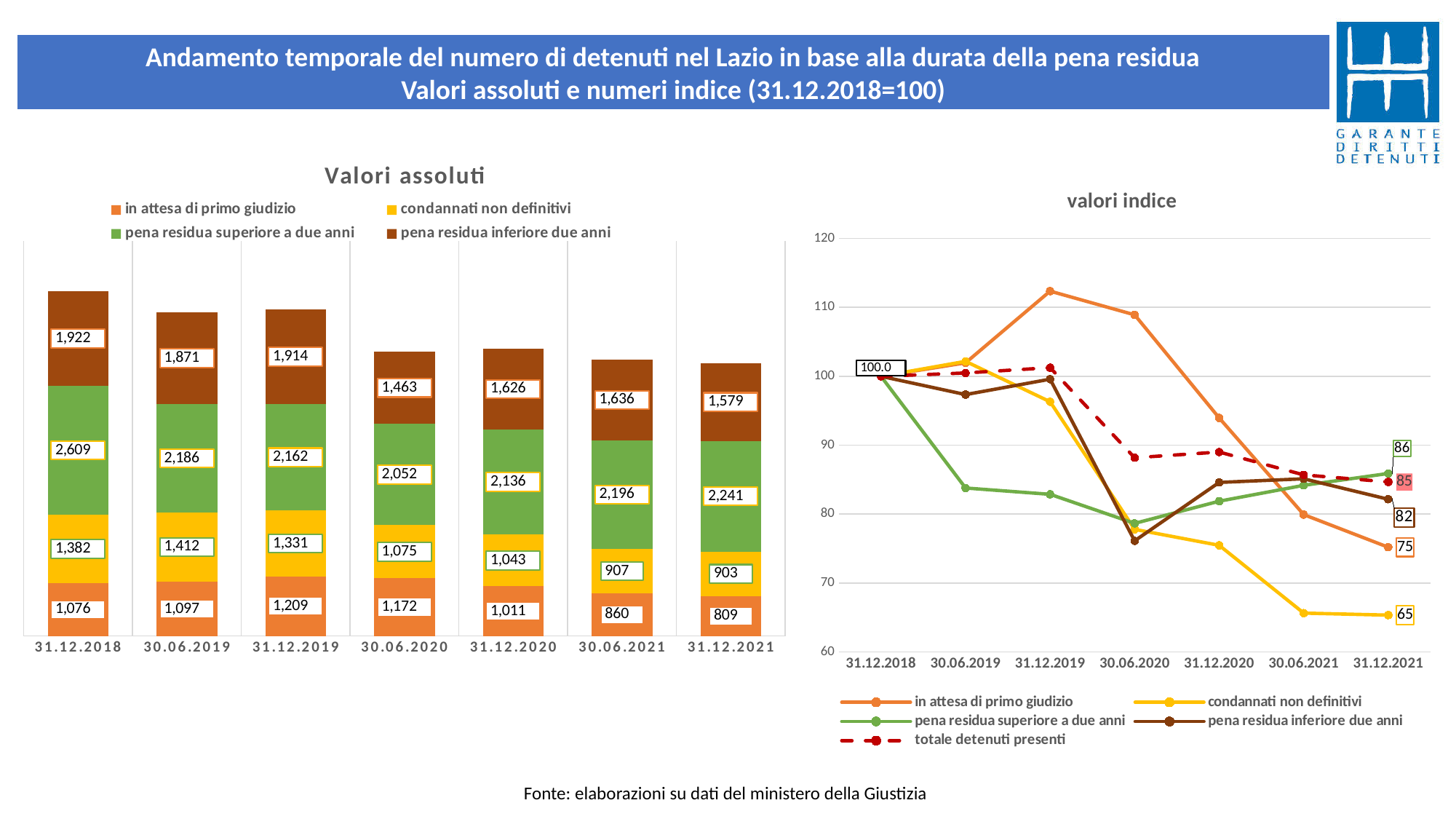
In the 'Valori assoluti' chart, what is the difference between the 'condannati non definitivi' values at 31.12.2018 and 31.12.2021? 479 In the 'Valori assoluti' chart, which date has the highest value for 'in attesa di primo giudizio'? 31.12.2019 In the 'valori indice' chart, is the value for 'in attesa di primo giudizio' at 31.12.2019 greater or less than 110? greater In the 'Valori assoluti' chart, what is the value for 'pena residua superiore a due anni' at 31.12.2018? 2,609 In the 'Valori assoluti' chart, what is the total of the stacked bar for 31.12.2021? 5,532 In the 'Valori assoluti' chart, how many dates are shown on the x axis? 7 In the 'valori indice' chart, what is the value for 'condannati non definitivi' at 31.12.2021? 65 In the 'Valori assoluti' chart, what is the value for 'in attesa di primo giudizio' at 31.12.2021? 809 In the 'Valori assoluti' chart, what is the value for 'pena residua inferiore due anni' at 30.06.2020? 1,463 In the 'Valori assoluti' chart, which date has the lowest value for 'condannati non definitivi'? 31.12.2021 In the 'valori indice' chart, how many series does the legend list? 5 What kind of chart is 'Valori assoluti'? Stacked bar chart